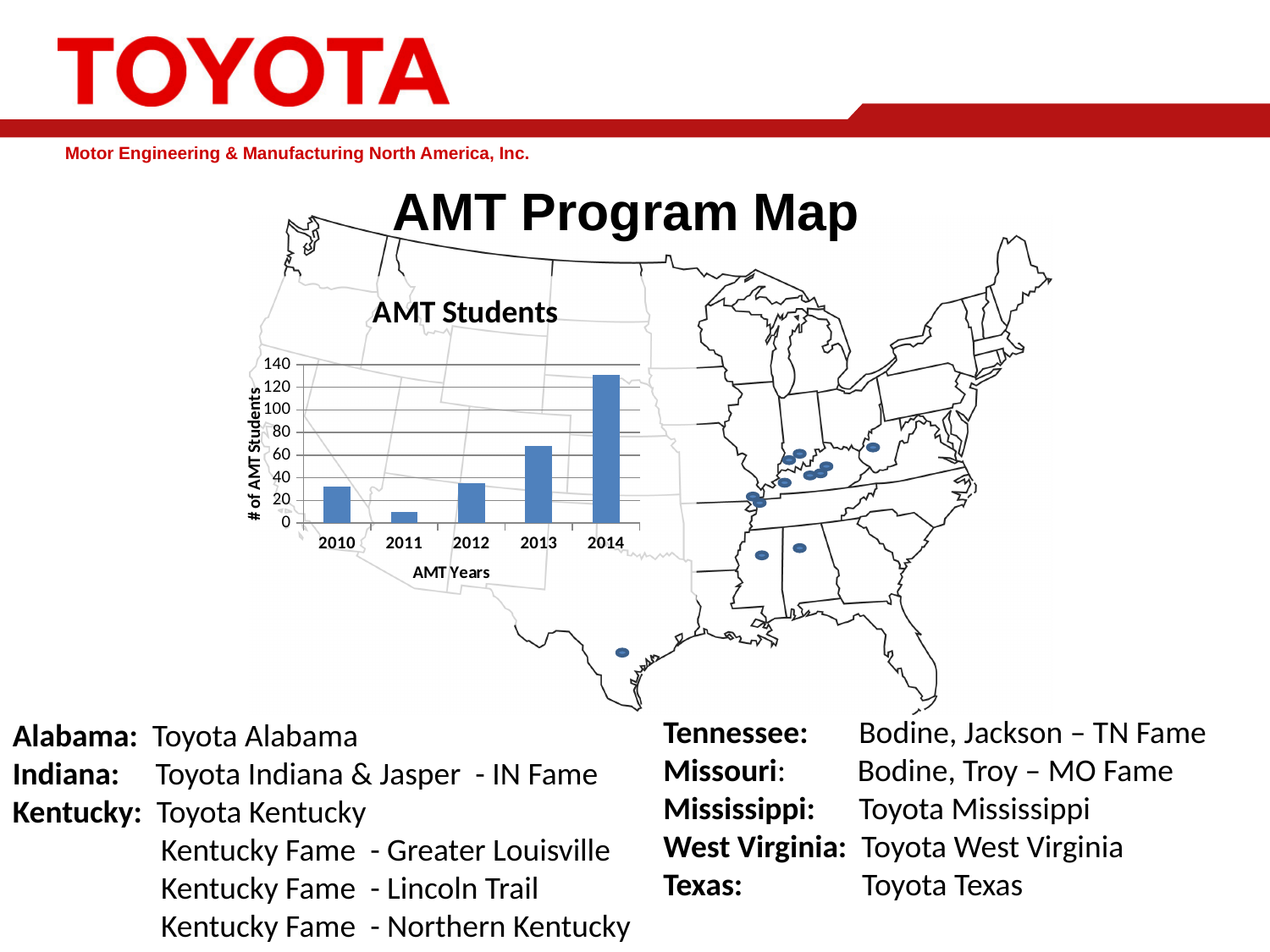
Which year has more AMT students, 2013 or 2014? 2014 Do the number of AMT students rise or fall from 2011 to 2014? rise Is the number of AMT students in 2014 greater or less than 120? greater Which year has the lowest number of AMT students? 2011 How many years are shown on the x axis of the AMT Students chart? 5 Is the number of AMT students in 2013 greater or less than 60? greater Is the number of AMT students in 2011 greater or less than 20? less What kind of chart is the AMT Students chart? bar chart Which year has the highest number of AMT students? 2014 Which year has more AMT students, 2010 or 2011? 2010 What is the label of the y axis on the AMT Students chart? # of AMT Students